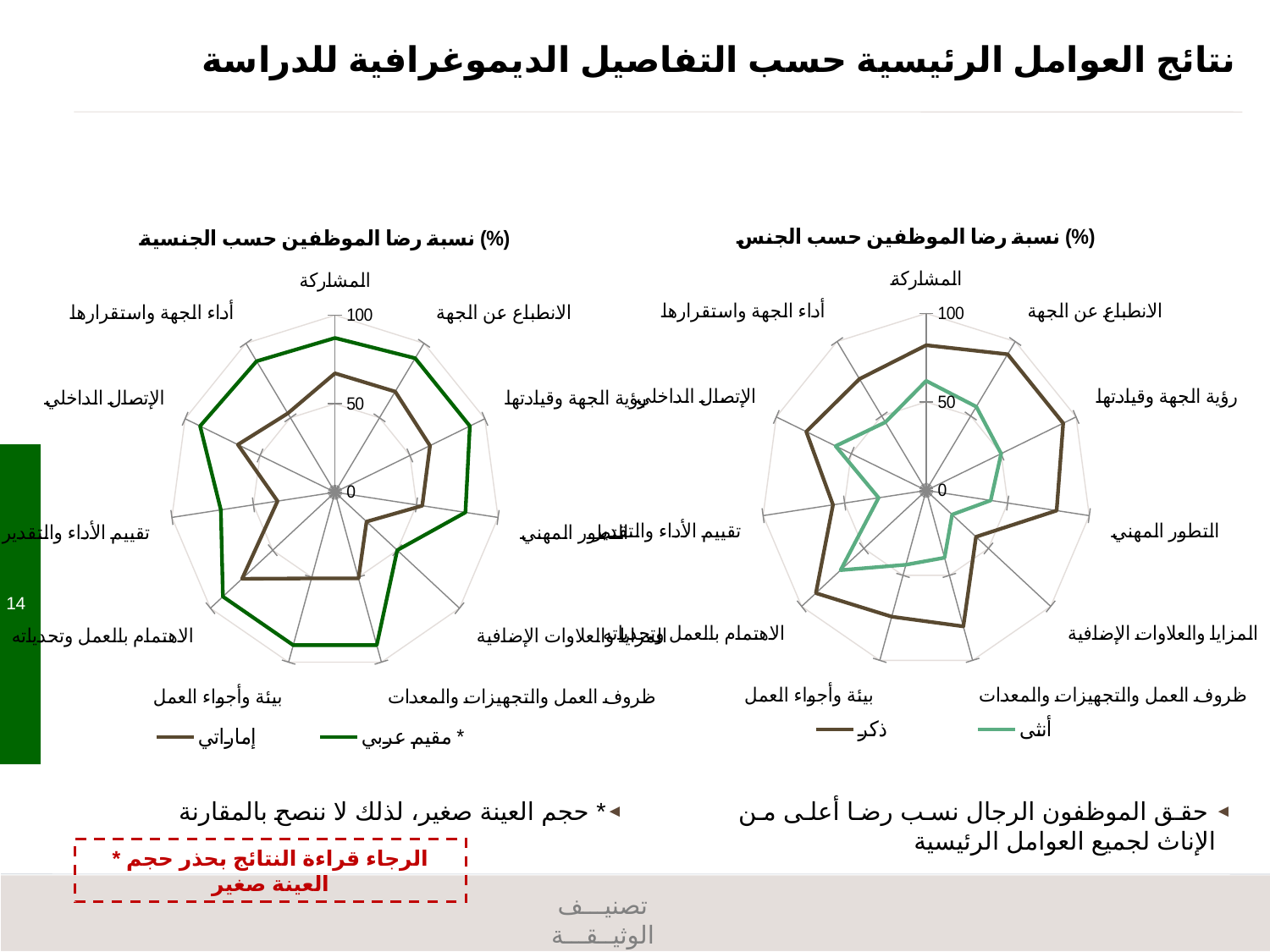
In the chart titled "(%) نسبة رضا الموظفين حسب الجنس", is the value of أنثى for التطور المهني greater or less than 50? less In the chart titled "(%) نسبة رضا الموظفين حسب الجنسية", is the value of مقيم عربي for الاهتمام بالعمل وتحدياته greater or less than 50? greater In the chart titled "(%) نسبة رضا الموظفين حسب الجنس", what are the two series named in the legend? ذكر and أنثى In the chart titled "(%) نسبة رضا الموظفين حسب الجنس", is the value of ذكر for المشاركة greater or less than 50? greater How many categories (axes) does the chart titled "(%) نسبة رضا الموظفين حسب الجنسية" have? 11 In the chart titled "(%) نسبة رضا الموظفين حسب الجنسية", which series has the larger value for الإتصال الداخلي, إماراتي or مقيم عربي? مقيم عربي In the chart titled "(%) نسبة رضا الموظفين حسب الجنسية", what is the maximum value shown on the axis scale? 100 In the chart titled "(%) نسبة رضا الموظفين حسب الجنس", which series has the larger value for المشاركة, ذكر or أنثى? ذكر What type of chart is the chart titled "(%) نسبة رضا الموظفين حسب الجنس"? Radar chart How many series does the legend of the chart titled "(%) نسبة رضا الموظفين حسب الجنسية" list? 2